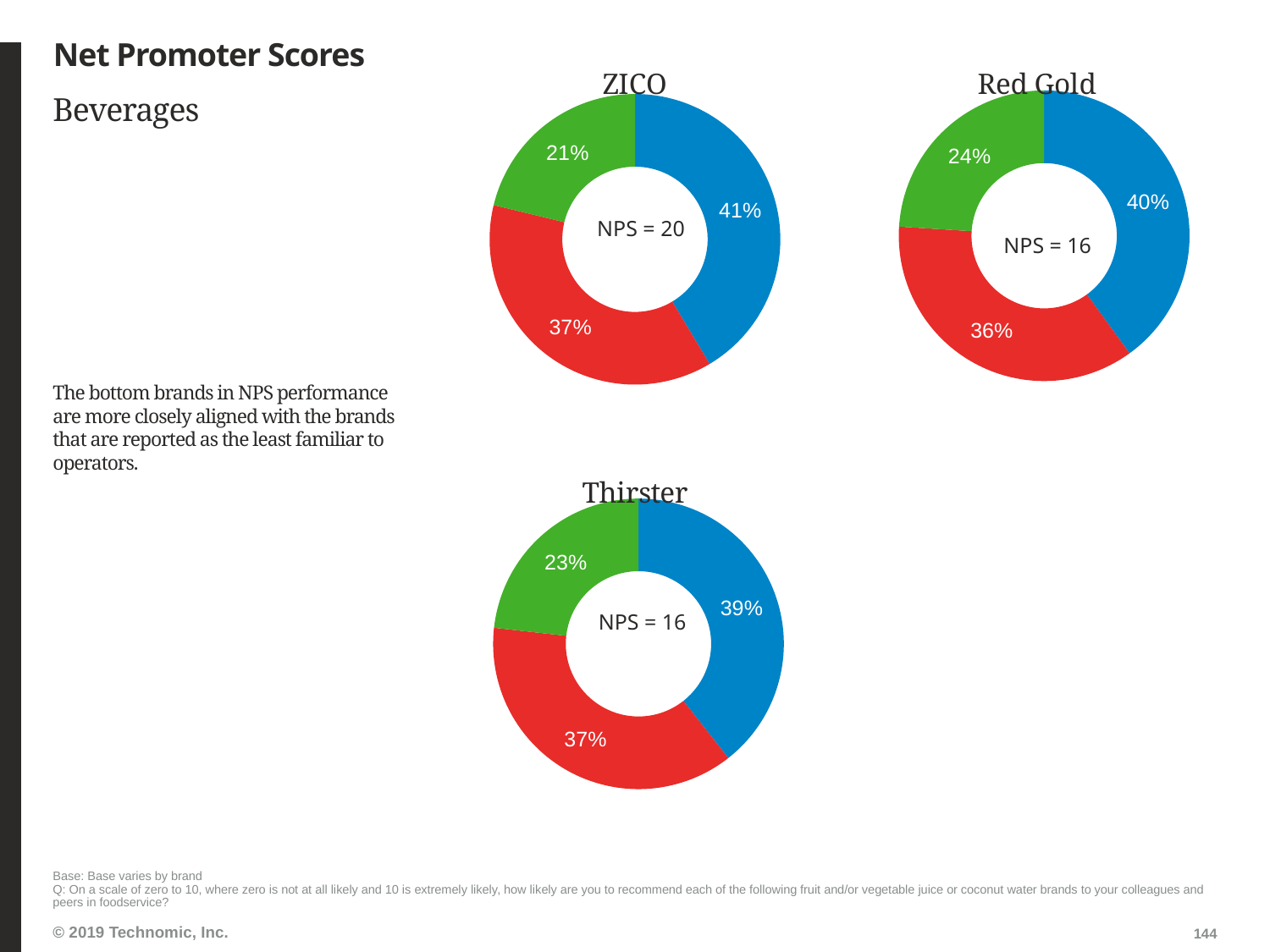
What NPS value is shown in the centre of the Red Gold chart? NPS = 16 In the Red Gold chart, what is the value of the green slice? 24% In the ZICO chart, what is the difference between the red slice and the green slice? 16% In the Thirster chart, what is the value of the red slice? 37% In the ZICO chart, which colour slice is the smallest? Green In the ZICO chart, what is the value of the blue slice? 41% Is the green slice larger in the ZICO chart or the Red Gold chart? Red Gold In the Thirster chart, which colour slice is the largest? Blue How many slices does the Thirster chart have? 3 What NPS value is shown in the centre of the ZICO chart? NPS = 20 What type of chart is used for ZICO, Red Gold and Thirster? Donut (pie) chart In the Red Gold chart, what is the difference between the blue slice and the green slice? 16%